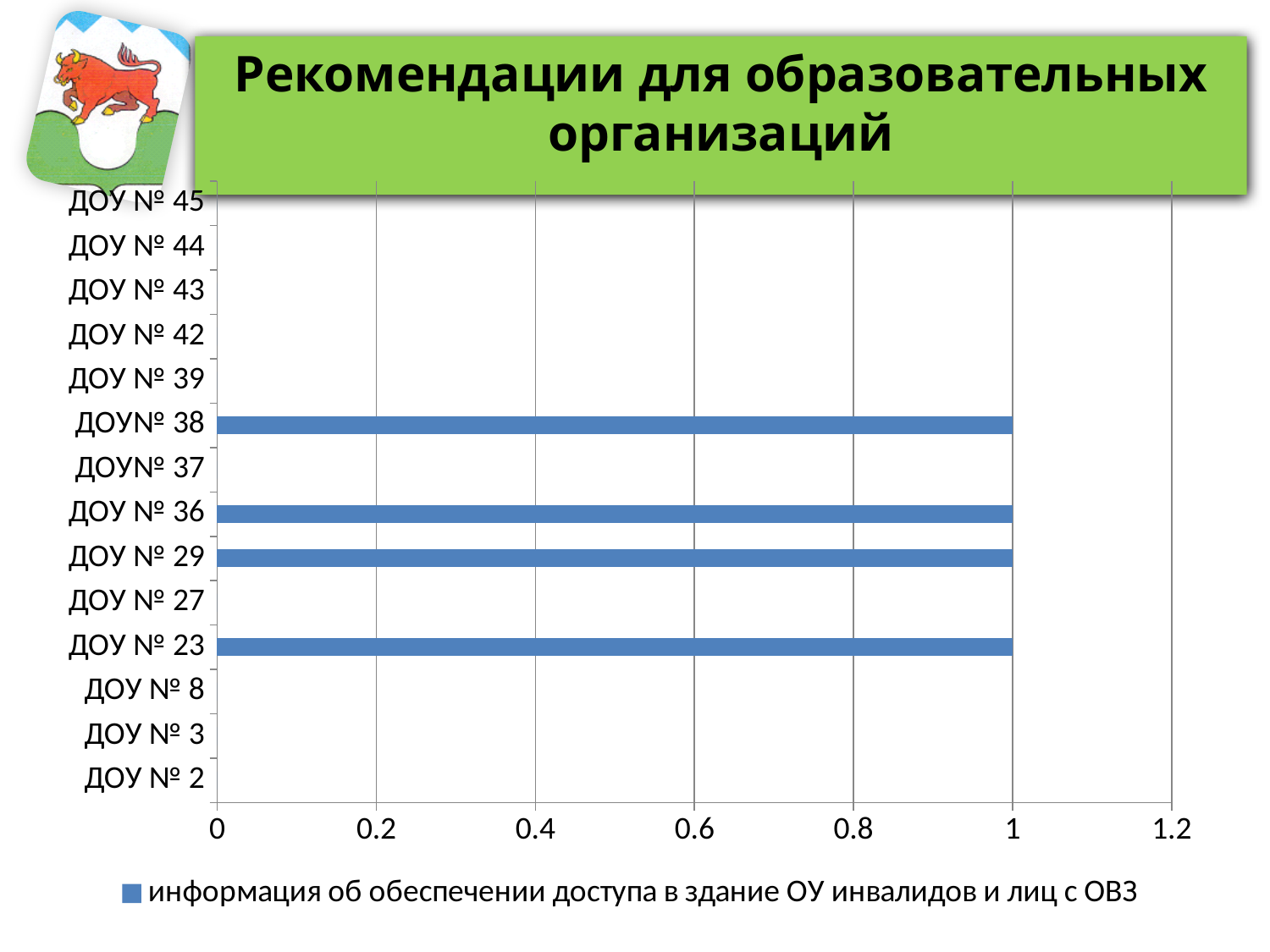
How many categories (ДОУ) are listed on the vertical axis of the chart? 14 What is the value for ДОУ № 23 in the chart? 1 What series name does the chart legend show? информация об обеспечении доступа в здание ОУ инвалидов и лиц с ОВЗ Is the value for ДОУ № 29 greater or less than 1.2? less How many categories in the chart have a visible bar? 4 What is the title shown at the top of the slide? Рекомендации для образовательных организаций What kind of chart is shown on the slide? bar chart Which is larger in the chart, the value for ДОУ № 36 or the value for ДОУ № 37? ДОУ № 36 What is the value for ДОУ № 38 in the chart? 1 Is the value for ДОУ № 36 greater or less than 0.8? greater How many series does the chart legend list? 1 Which is larger in the chart, the value for ДОУ № 29 or the value for ДОУ № 27? ДОУ № 29